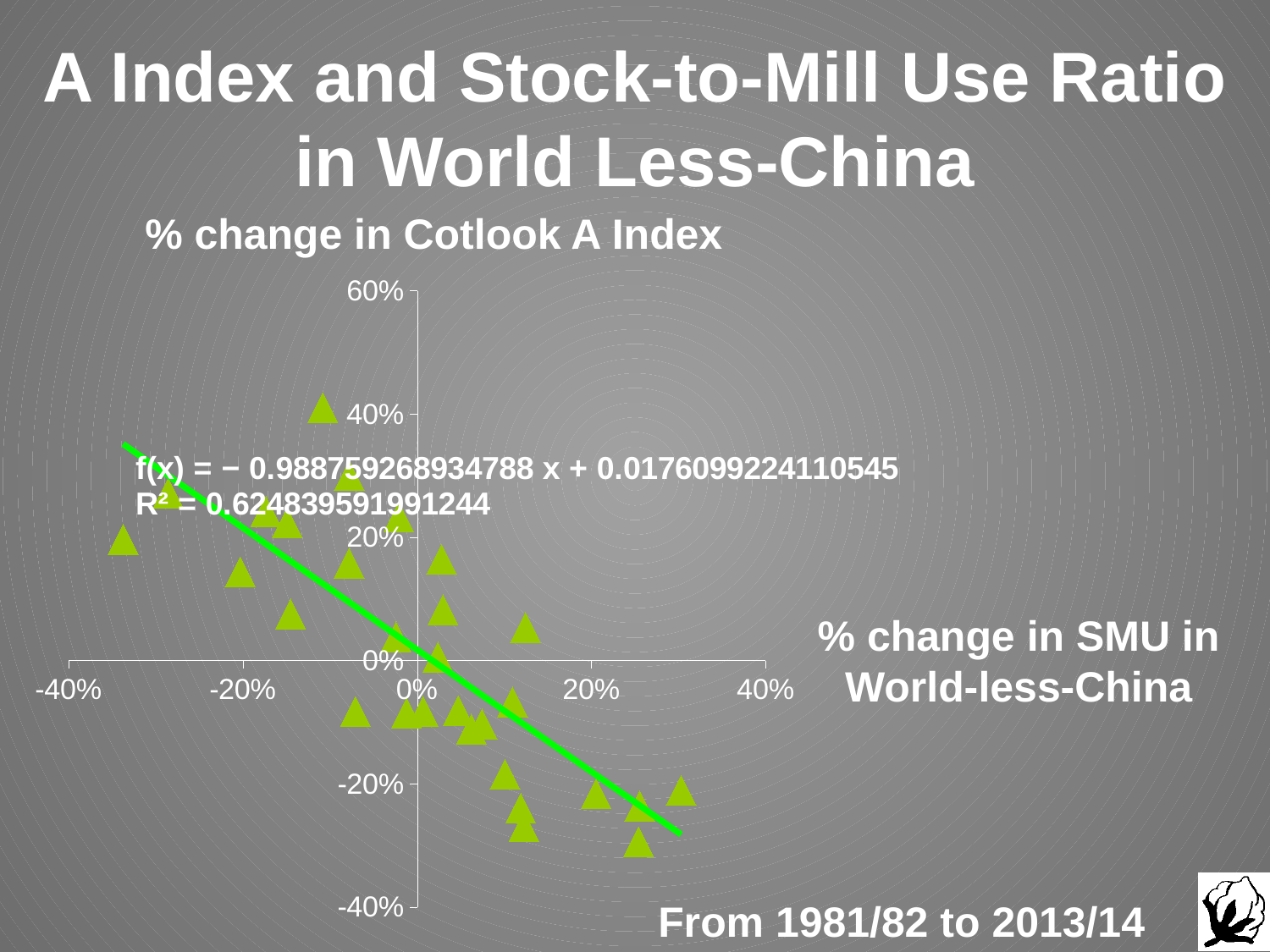
Is the slope of the trend line positive or negative? negative Is the x value of the leftmost point on the chart greater or less than -20%? less What is the highest value shown on the y axis? 60% Is the y value of the lowest point on the chart greater or less than -20%? less What is the R² value printed on the chart? 0.624839591991244 What is the trend line equation printed on the chart? f(x) = − 0.988759268934788 x + 0.0176099224110545 As the % change in SMU in World-less-China increases along the x axis, do the % changes in the Cotlook A Index generally rise or fall? fall What kind of chart is shown on the slide? scatter chart Is the x value of the rightmost point on the chart greater or less than 20%? greater What is the lowest value shown on the x axis? -40%